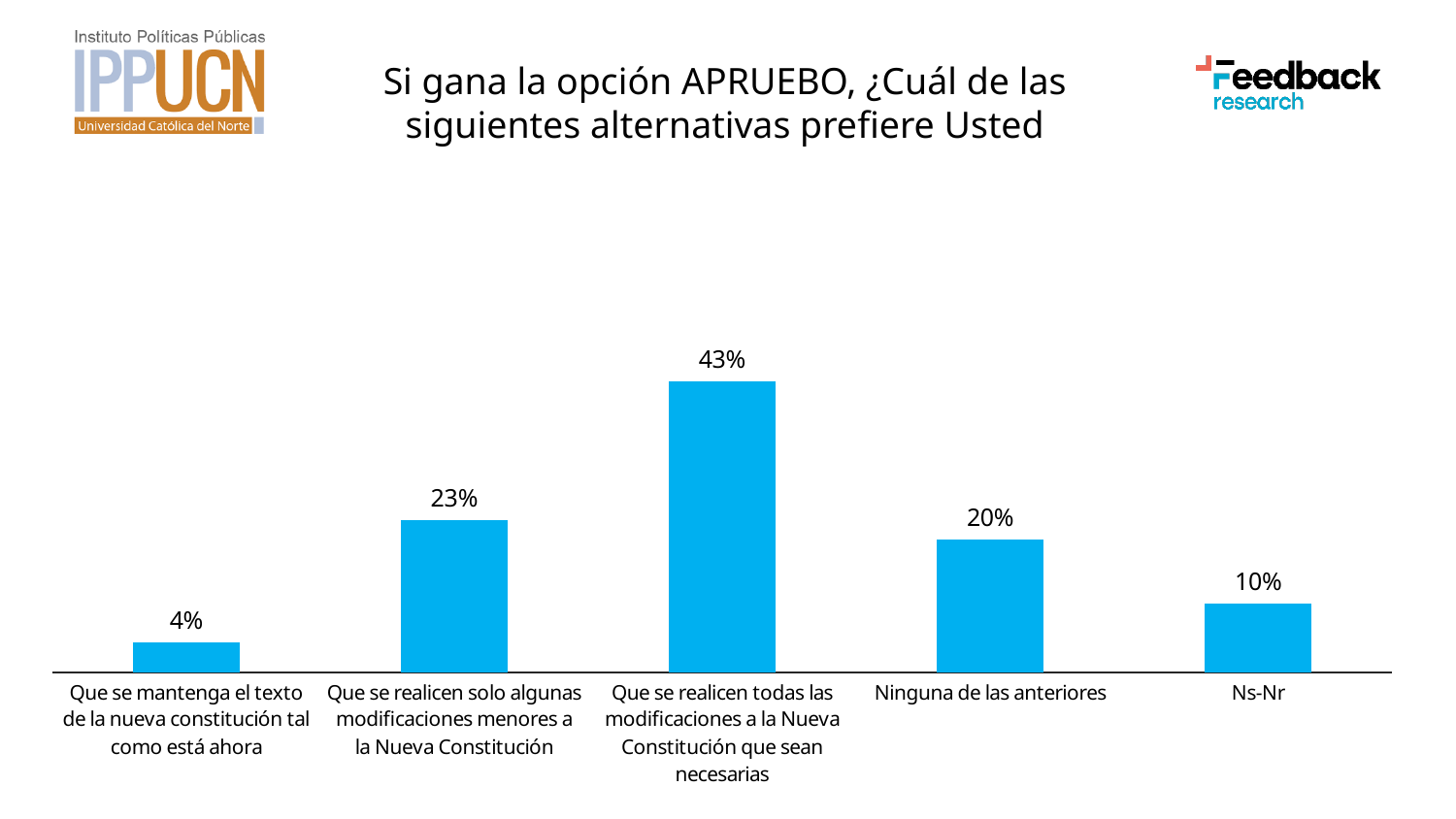
What kind of chart is shown on the slide? Bar chart What percentage is shown for "Ninguna de las anteriores"? 20% What is the difference between the values for "Ninguna de las anteriores" and "Ns-Nr"? 10% What percentage of respondents chose "Que se realicen todas las modificaciones a la Nueva Constitución que sean necesarias"? 43% What is the difference between the values for "Que se realicen todas las modificaciones a la Nueva Constitución que sean necesarias" and "Que se realicen solo algunas modificaciones menores a la Nueva Constitución"? 20% What is the value for "Que se mantenga el texto de la nueva constitución tal como está ahora"? 4% How many categories are shown in the chart? 5 What is the value shown for "Ns-Nr"? 10% What is the title of the chart? Si gana la opción APRUEBO, ¿Cuál de las siguientes alternativas prefiere Usted Which is larger: the value for "Que se realicen solo algunas modificaciones menores a la Nueva Constitución" or the value for "Ninguna de las anteriores"? Que se realicen solo algunas modificaciones menores a la Nueva Constitución Which category has the highest value? Que se realicen todas las modificaciones a la Nueva Constitución que sean necesarias Which category has the lowest value? Que se mantenga el texto de la nueva constitución tal como está ahora